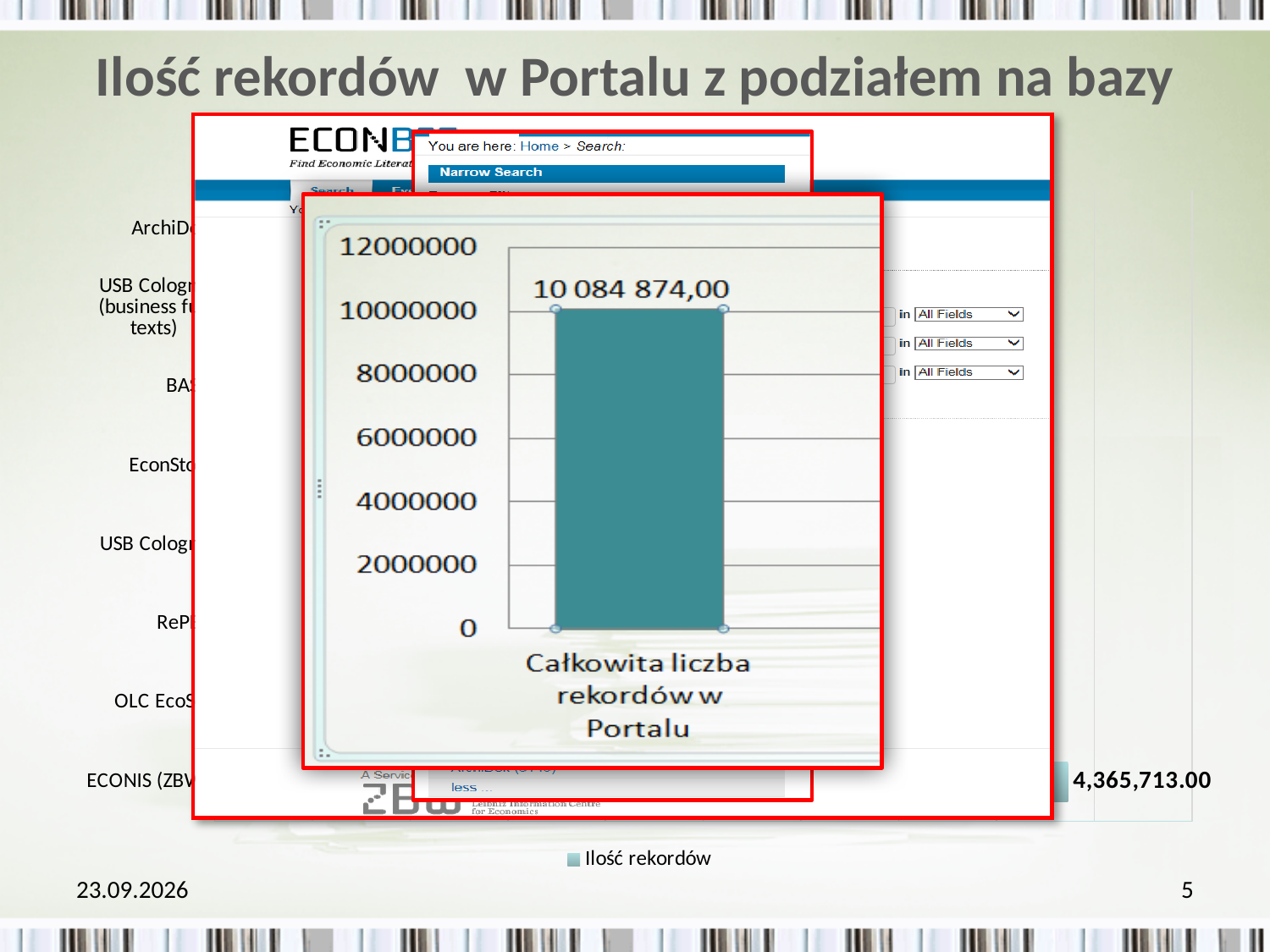
How many bars does the overlaid chart 'Całkowita liczba rekordów w Portalu' contain? 1 What kind of chart is the overlaid chart showing 'Całkowita liczba rekordów w Portalu'? bar chart What is the difference between the overlaid chart's bar value (10 084 874,00) and the ECONIS value (4,365,713.00) in the background chart? 5,719,161.00 In the overlaid chart titled 'Całkowita liczba rekordów w Portalu', what value is printed on the bar? 10 084 874,00 In the background chart 'Ilość rekordów w Portalu z podziałem na bazy', what value is printed next to the bottom bar (ECONIS)? 4,365,713.00 In the overlaid chart, is the value of the bar greater or less than 12000000? less What is the category label under the bar in the overlaid chart? Całkowita liczba rekordów w Portalu Which is larger: the bar value in the overlaid chart (10 084 874,00) or the ECONIS value in the background chart (4,365,713.00)? 10 084 874,00 What is the highest tick value shown on the vertical axis of the overlaid chart? 12000000 What kind of chart is the background chart 'Ilość rekordów w Portalu z podziałem na bazy'? bar chart How many series does the legend of the background chart 'Ilość rekordów w Portalu z podziałem na bazy' list? 1 In the overlaid chart, is the value of the bar greater or less than 8000000? greater